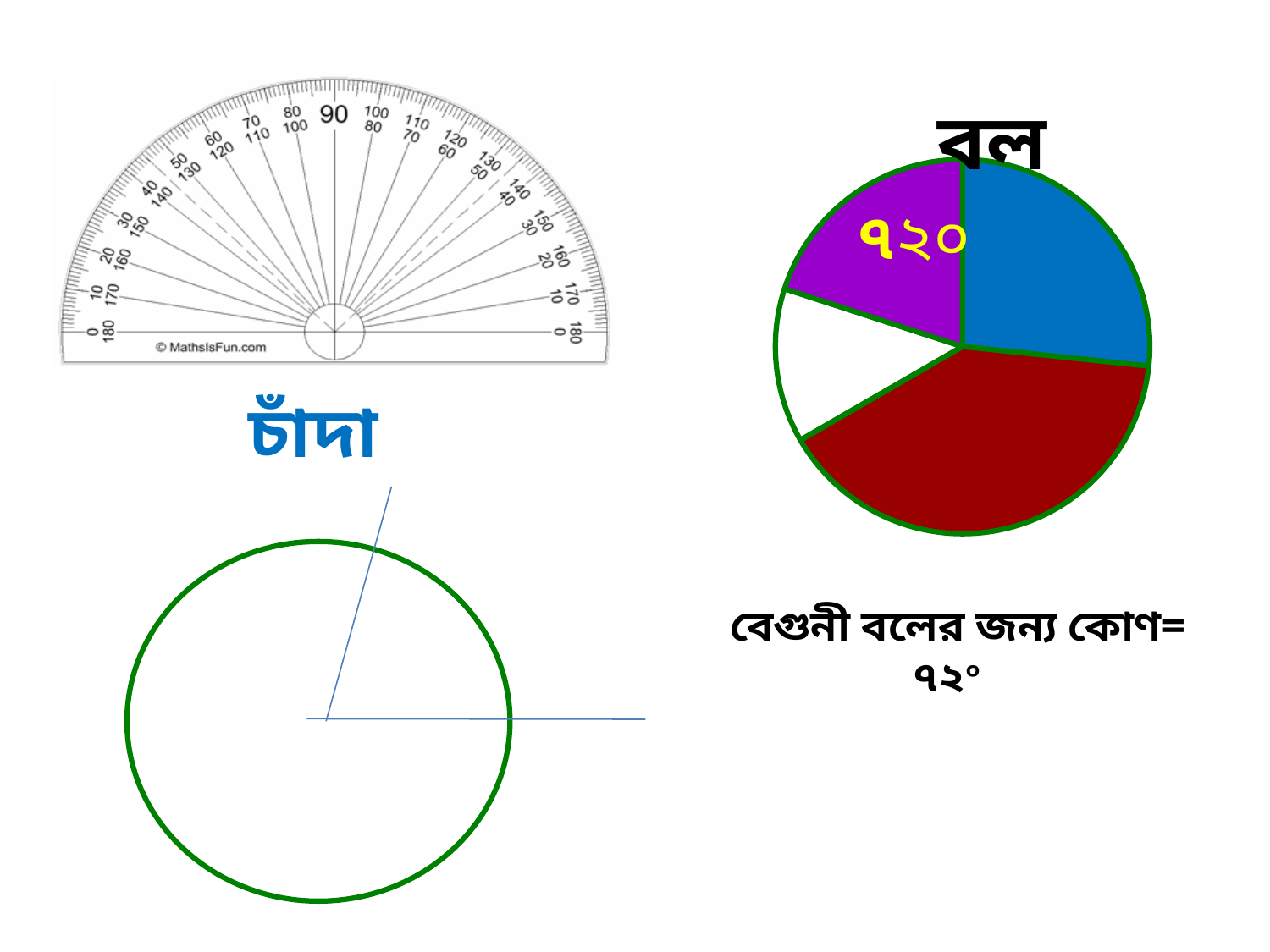
How many slices does the pie chart have? 4 What label is printed on the purple slice of the pie chart? ৭২০ Which slice is larger in the pie chart, the red slice or the blue slice? the red slice Which slice is larger in the pie chart, the red slice or the purple slice? the red slice What colour is the slice of the pie chart that carries a printed label? purple What is the title of the pie chart? বল According to the text below the pie chart, what is the angle for the purple ball? ৭২° What kind of chart is shown on the right side of the slide? pie chart Which slice of the pie chart is the largest? the red slice Which slice is larger in the pie chart, the blue slice or the purple slice? the blue slice